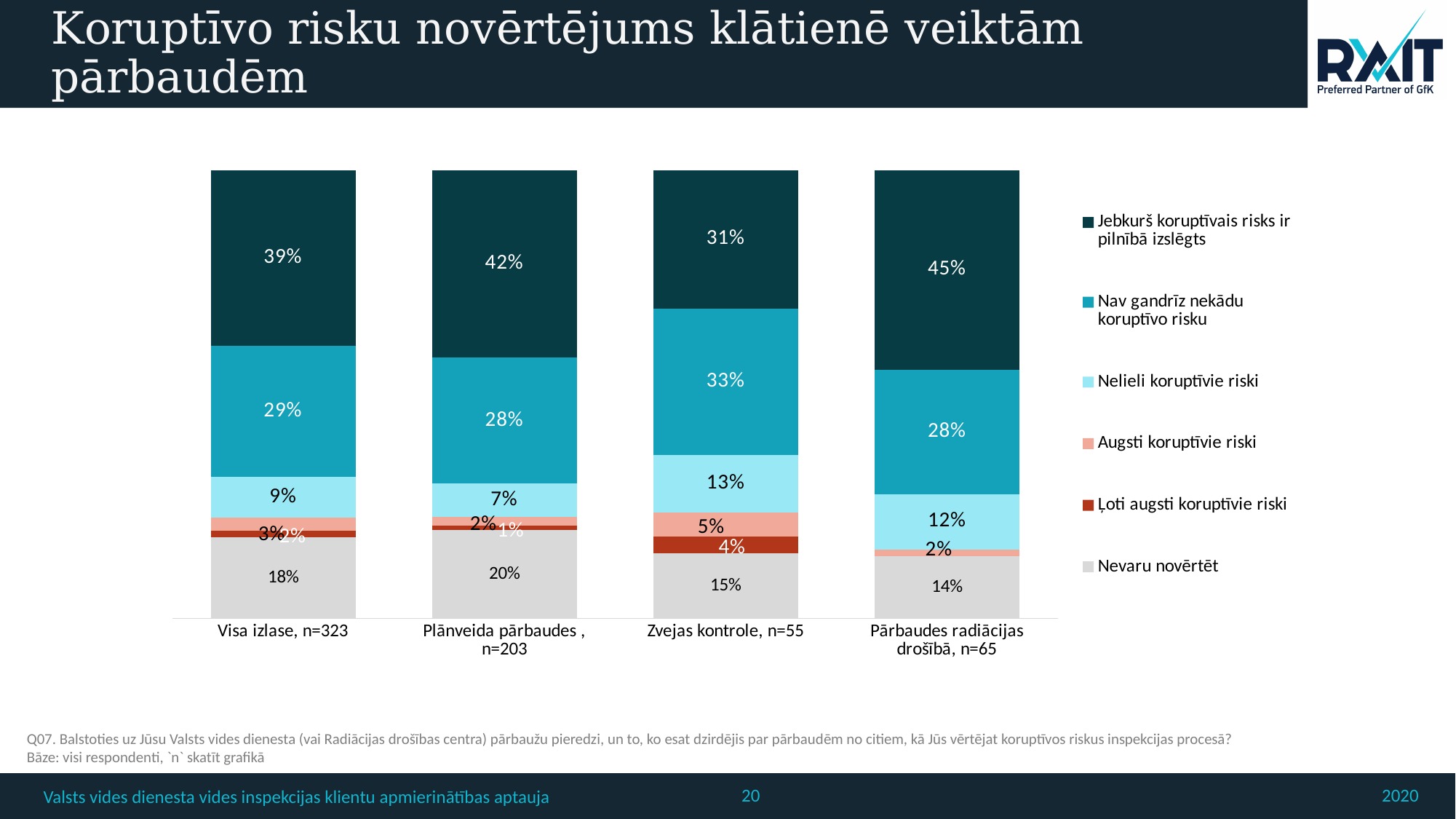
What is the value of 'Jebkurš koruptīvais risks ir pilnībā izslēgts' for 'Pārbaudes radiācijas drošībā, n=65'? 45% Which category has the lowest value for 'Nevaru novērtēt'? Pārbaudes radiācijas drošībā, n=65 What is the value of 'Nav gandrīz nekādu koruptīvo risku' for 'Zvejas kontrole, n=55'? 33% Which category has the highest value for 'Jebkurš koruptīvais risks ir pilnībā izslēgts'? Pārbaudes radiācijas drošībā, n=65 How many categories (bars) are shown on the x axis? 4 What is the value of 'Nelieli koruptīvie riski' for 'Visa izlase, n=323'? 9% What is the value of 'Nevaru novērtēt' for 'Plānveida pārbaudes, n=203'? 20% How many series does the legend list? 6 Which is larger: 'Augsti koruptīvie riski' for 'Zvejas kontrole, n=55' or for 'Visa izlase, n=323'? Zvejas kontrole, n=55 Which legend entry is shown in grey? Nevaru novērtēt What is the difference between the 'Jebkurš koruptīvais risks ir pilnībā izslēgts' values for 'Plānveida pārbaudes, n=203' and 'Zvejas kontrole, n=55'? 11 percentage points What kind of chart is shown on the slide? Stacked bar chart